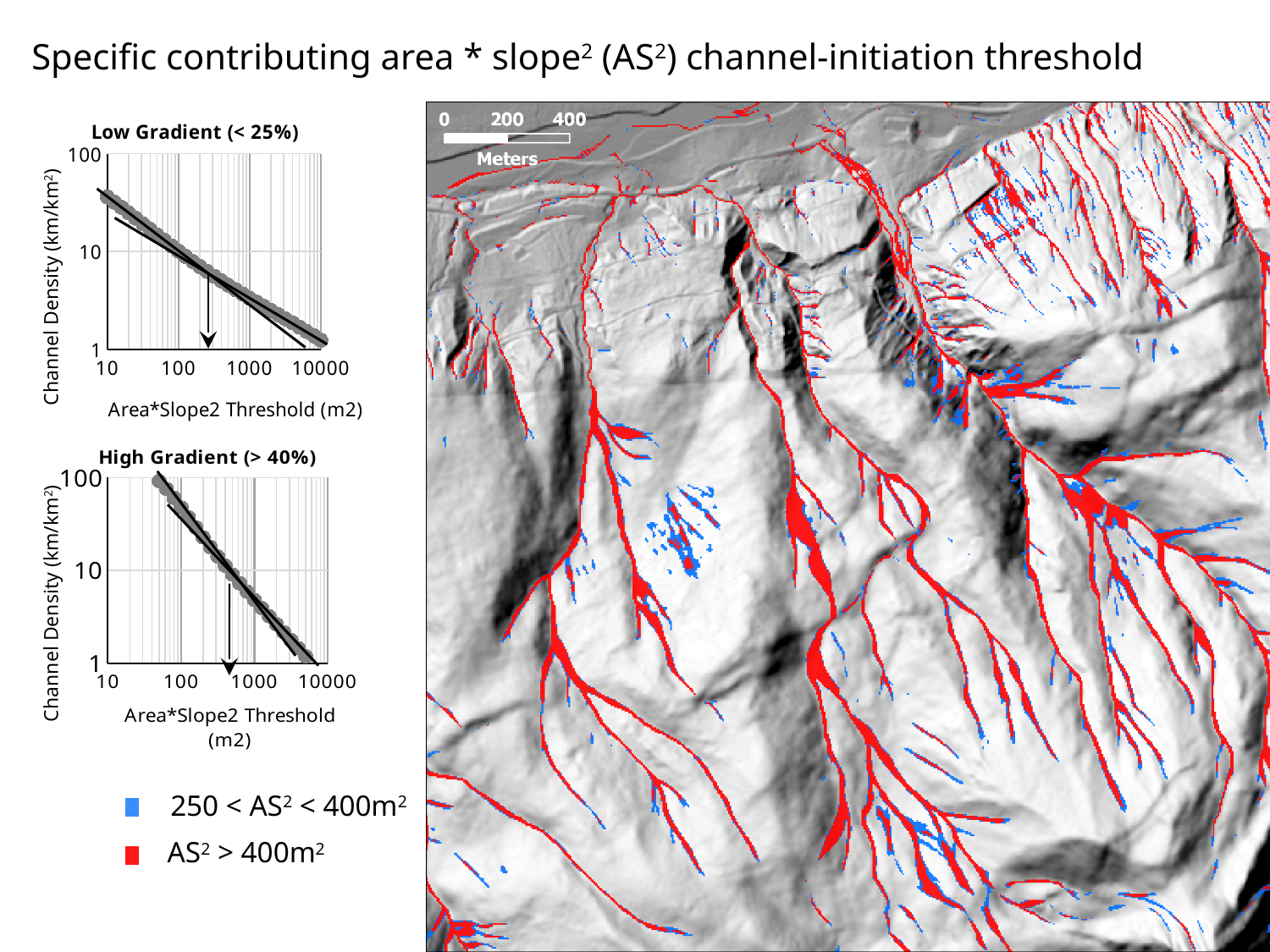
In the "High Gradient (> 40%)" chart, is the channel density at an Area*Slope2 threshold of 100 greater or less than 10 km/km²? greater In the "High Gradient (> 40%)" chart, does channel density rise or fall as the Area*Slope2 threshold increases? fall In the "High Gradient (> 40%)" chart, which has the higher channel density: the point at an Area*Slope2 threshold of 100 or the point at 1000? 100 In the "High Gradient (> 40%)" chart, is the channel density at an Area*Slope2 threshold of 1000 greater or less than 10 km/km²? less What kind of chart is the "Low Gradient (< 25%)" chart? scatter chart What is the x-axis label of the "High Gradient (> 40%)" chart? Area*Slope2 Threshold (m2) In the "Low Gradient (< 25%)" chart, does channel density rise or fall as the Area*Slope2 threshold increases? fall In the "Low Gradient (< 25%)" chart, which has the higher channel density: the point at an Area*Slope2 threshold of 10 or the point at 10000? 10 In the "Low Gradient (< 25%)" chart, is the channel density at an Area*Slope2 threshold of 10 greater or less than 10 km/km²? greater What is the y-axis label of the "Low Gradient (< 25%)" chart? Channel Density (km/km²) How many charts with a Channel Density y-axis are shown on the slide? 2